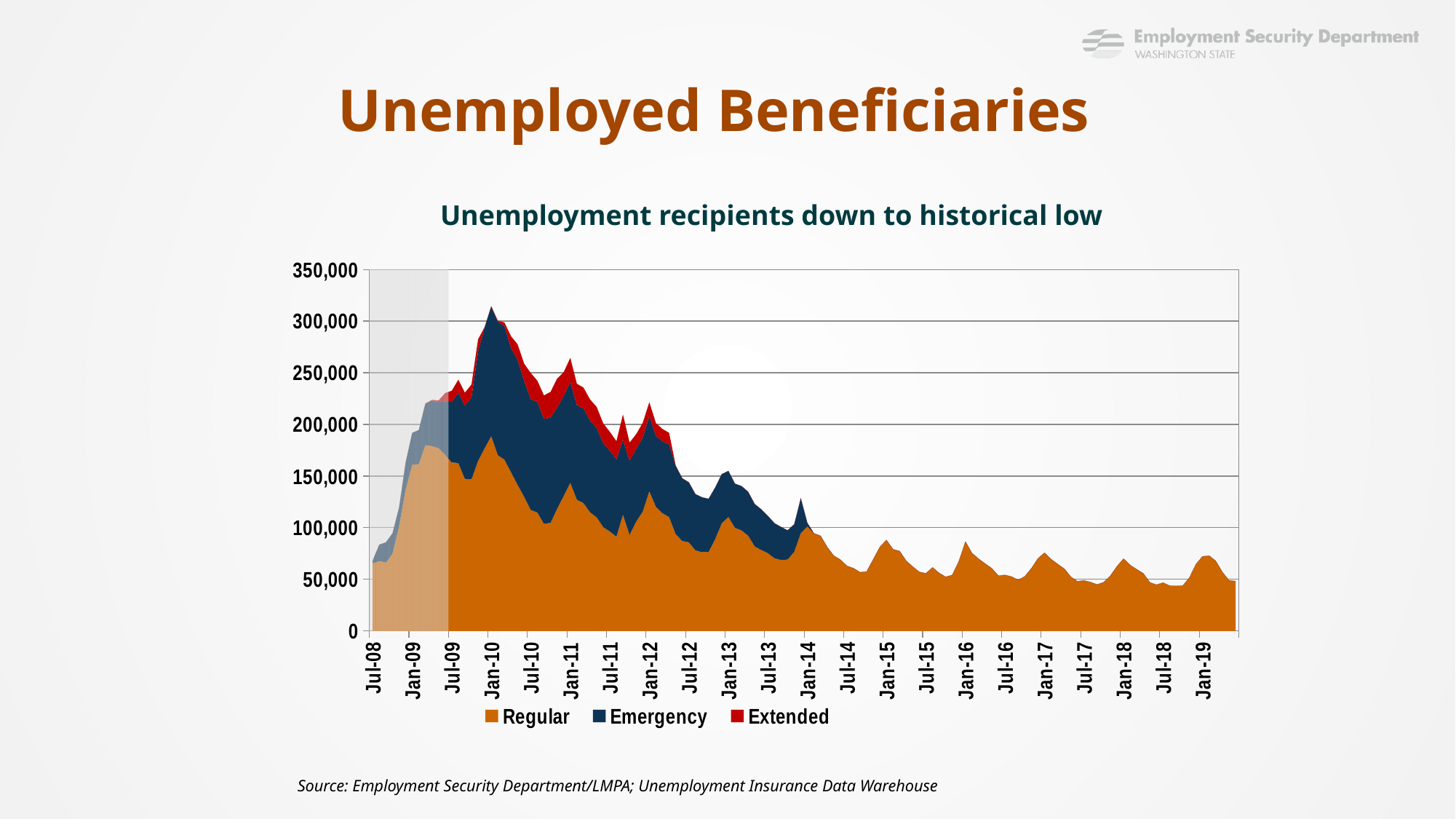
Which series accounts for the smallest share of beneficiaries? Extended What kind of chart is shown on the slide? Stacked area chart Is the value for Regular beneficiaries at Jan-19 greater or less than 100,000? less What are the three series named in the legend? Regular, Emergency, Extended At Jan-10, which is larger: Regular or Emergency beneficiaries? Regular Is the total number of beneficiaries at Jul-08 greater or less than 100,000? less Is the total number of beneficiaries at Jan-10 greater or less than 250,000? greater How many series does the legend list? 3 Which series accounts for the largest share of beneficiaries throughout the chart? Regular What is the title shown above the chart? Unemployment recipients down to historical low Does the total number of beneficiaries rise or fall from Jan-10 to Jan-14? Fall